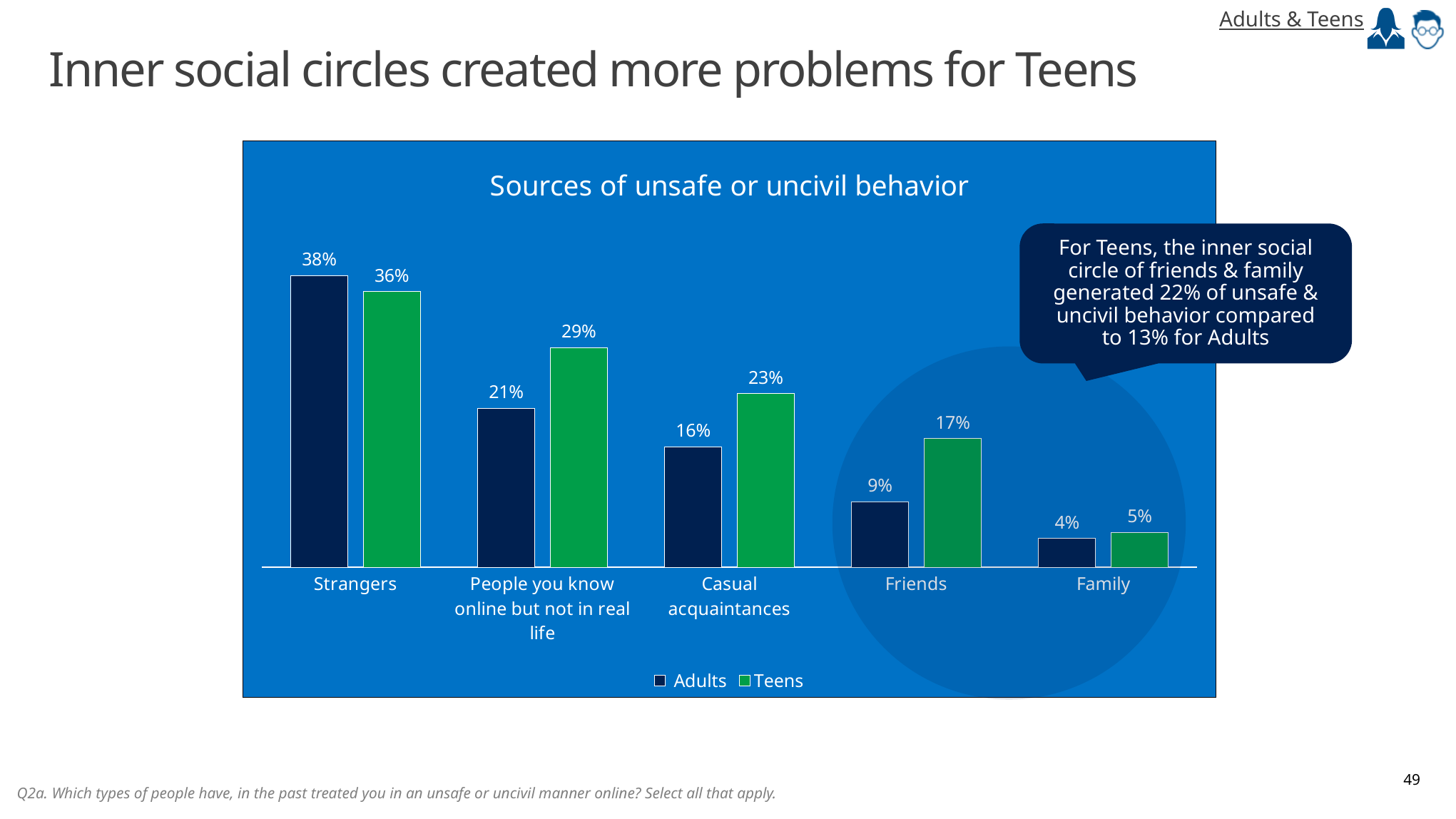
Which category has the lowest value for Adults? Family Which category has the highest value for Teens? Strangers How many series does the legend list? 2 Which is larger in the Friends category, the Adults value or the Teens value? Teens What is the value for Teens in the Casual acquaintances category? 23% What is the value for Teens in the Friends category? 17% What kind of chart is shown on the slide? Bar chart What is the title of the chart? Sources of unsafe or uncivil behavior Do the Adults values rise or fall moving from Strangers to Family along the x axis? Fall What is the difference between the Teens and Adults values for People you know online but not in real life? 8% How many categories are shown on the x axis? 5 What is the value for Adults in the Strangers category? 38%